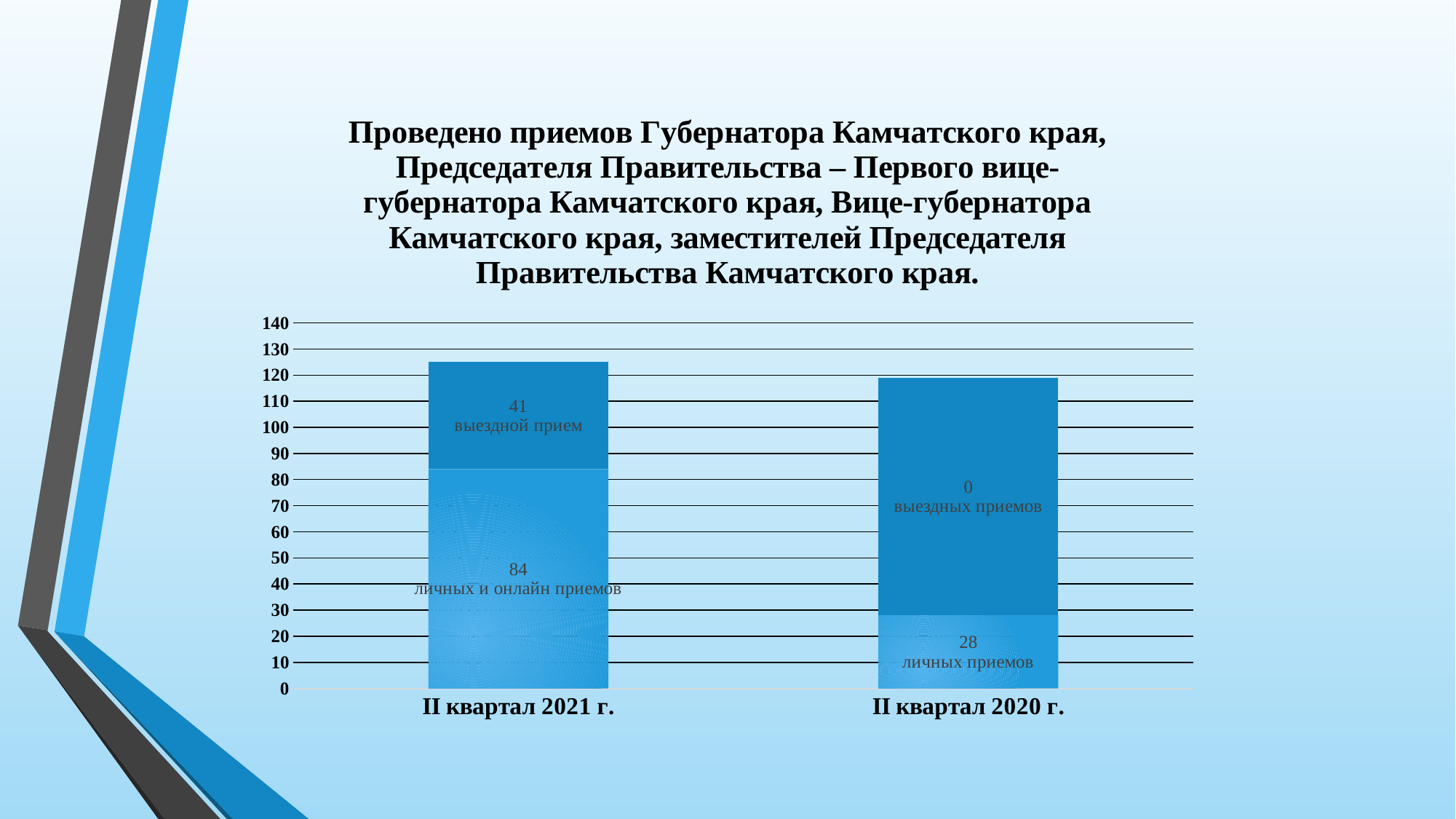
How many выездной прием were held in II квартал 2021 г.? 41 How many личных и онлайн приемов were held in II квартал 2021 г.? 84 How many выездных приемов are labelled for II квартал 2020 г.? 0 What is the highest value shown on the vertical axis of the chart? 140 What is the difference between the личных и онлайн приемов in II квартал 2021 г. (84) and the личных приемов in II квартал 2020 г. (28)? 56 Which of the two bars is taller overall? II квартал 2021 г. How many categories are shown on the x axis of the chart? 2 What is the total of the stacked bar for II квартал 2021 г. (84 + 41)? 125 Which quarter has the larger number of личных приемов, II квартал 2021 г. or II квартал 2020 г.? II квартал 2021 г. Is the top of the bar for II квартал 2020 г. greater or less than 100? greater How many личных приемов were held in II квартал 2020 г.? 28 What kind of chart is shown on the slide? bar chart